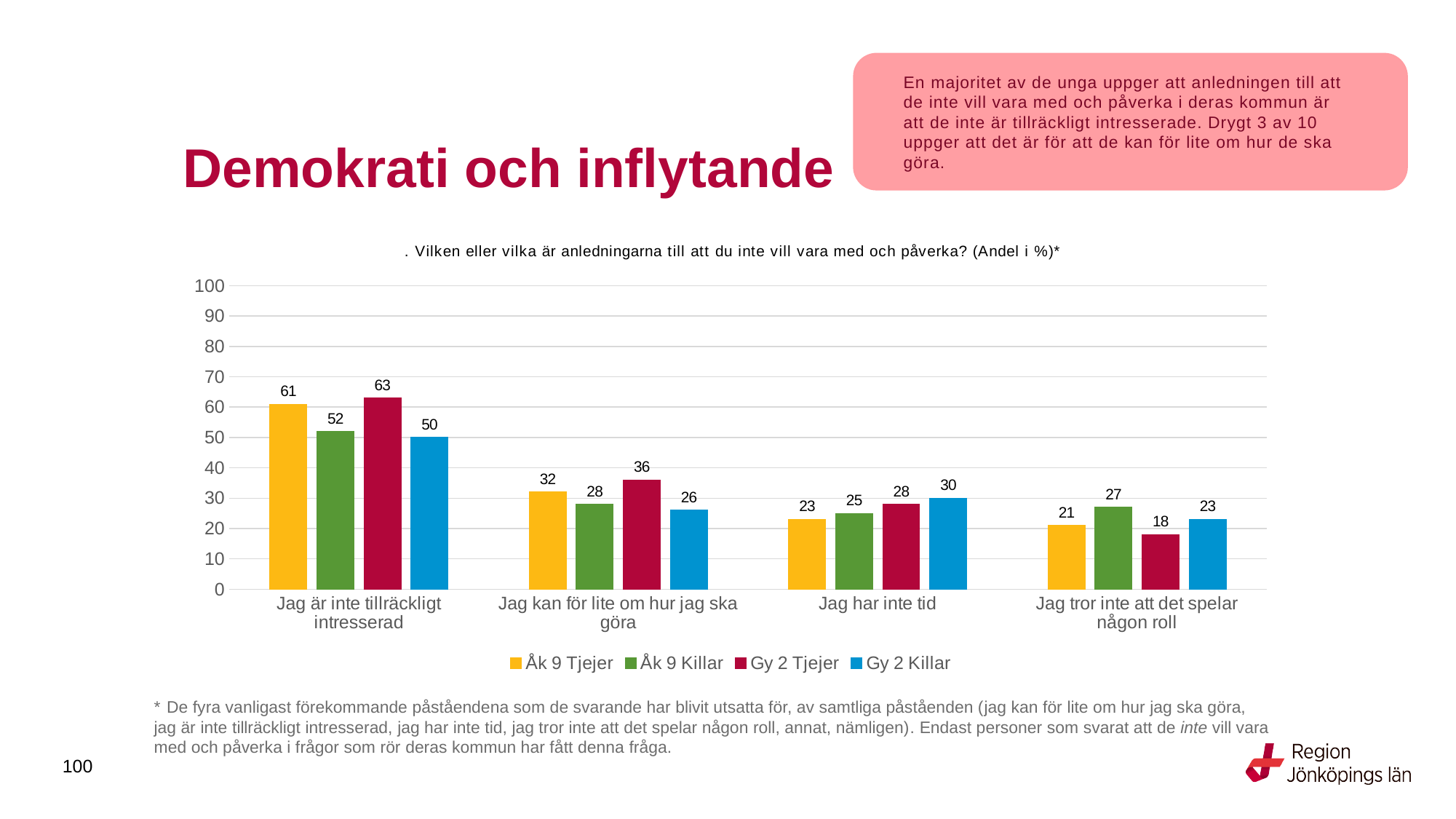
What is the difference between the Gy 2 Tjejer and Åk 9 Killar values in the category "Jag är inte tillräckligt intresserad"? 11 What is the value for Gy 2 Tjejer in the category "Jag är inte tillräckligt intresserad"? 63 What is the value for Gy 2 Killar in the category "Jag har inte tid"? 30 Which series has the highest value in the category "Jag tror inte att det spelar någon roll"? Åk 9 Killar What colour are the bars for the Gy 2 Tjejer series? Dark red Which is larger in the category "Jag kan för lite om hur jag ska göra": Åk 9 Tjejer or Gy 2 Killar? Åk 9 Tjejer What is the value for Åk 9 Killar in the category "Jag kan för lite om hur jag ska göra"? 28 How many categories are shown on the x axis of the chart? 4 Which series has the lowest value in the category "Jag är inte tillräckligt intresserad"? Gy 2 Killar What kind of chart is shown on the slide? Bar chart Which category has the highest value for Åk 9 Tjejer? Jag är inte tillräckligt intresserad How many series does the legend list? 4